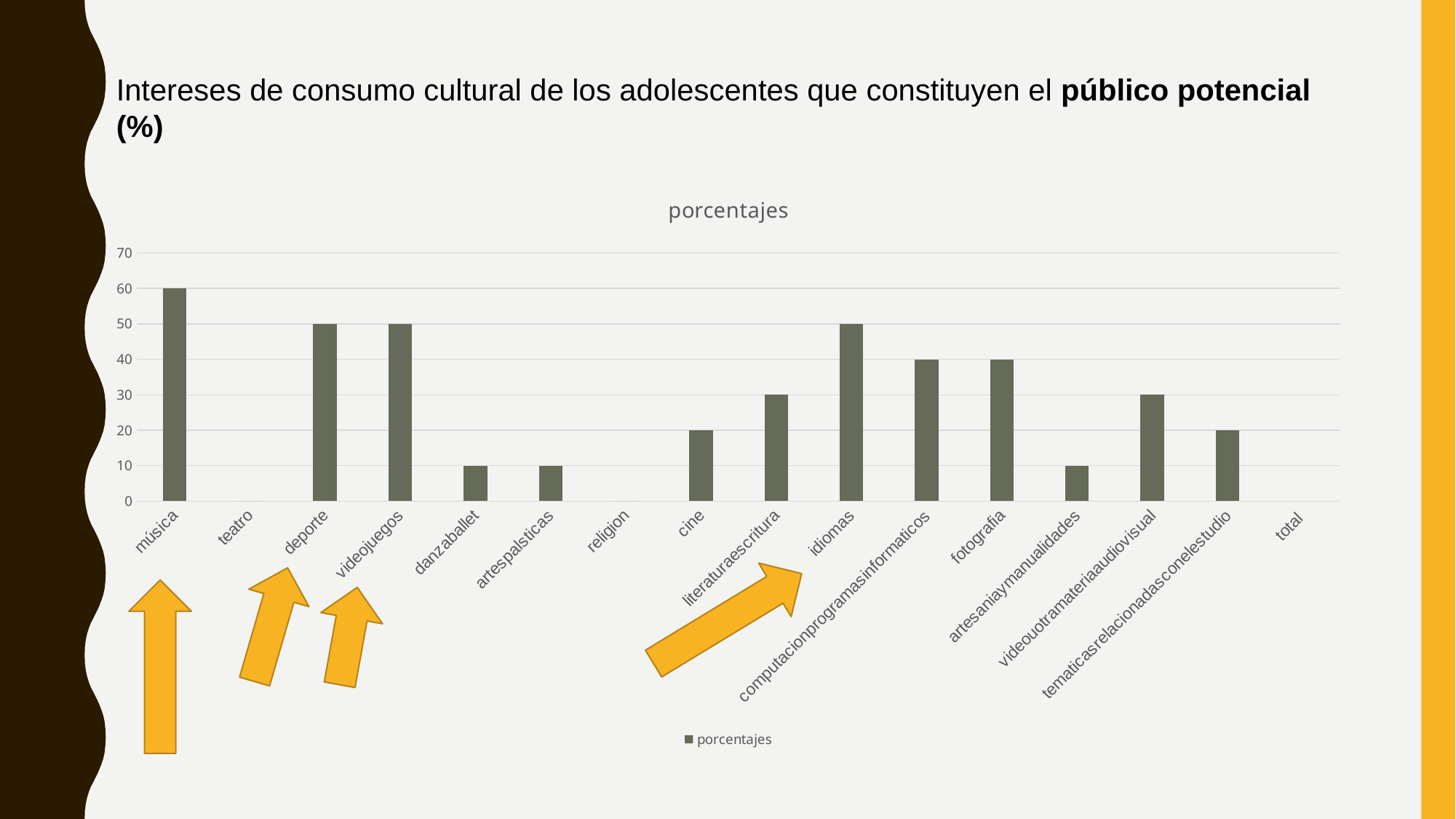
Is the value for danzaballet greater or less than 20? less How many categories are shown on the x axis? 16 What is the title of the chart? porcentajes How many series does the legend list? 1 What is the value for música? 60 Which category has the highest value? música Is the value for computacionprogramasinformaticos greater or less than 30? greater What kind of chart is shown on the slide? bar chart What is the value for cine? 20 What is the difference between the values for música and deporte? 10 Which is larger, the value for fotografia or the value for literaturaescritura? fotografia What is the value for idiomas? 50